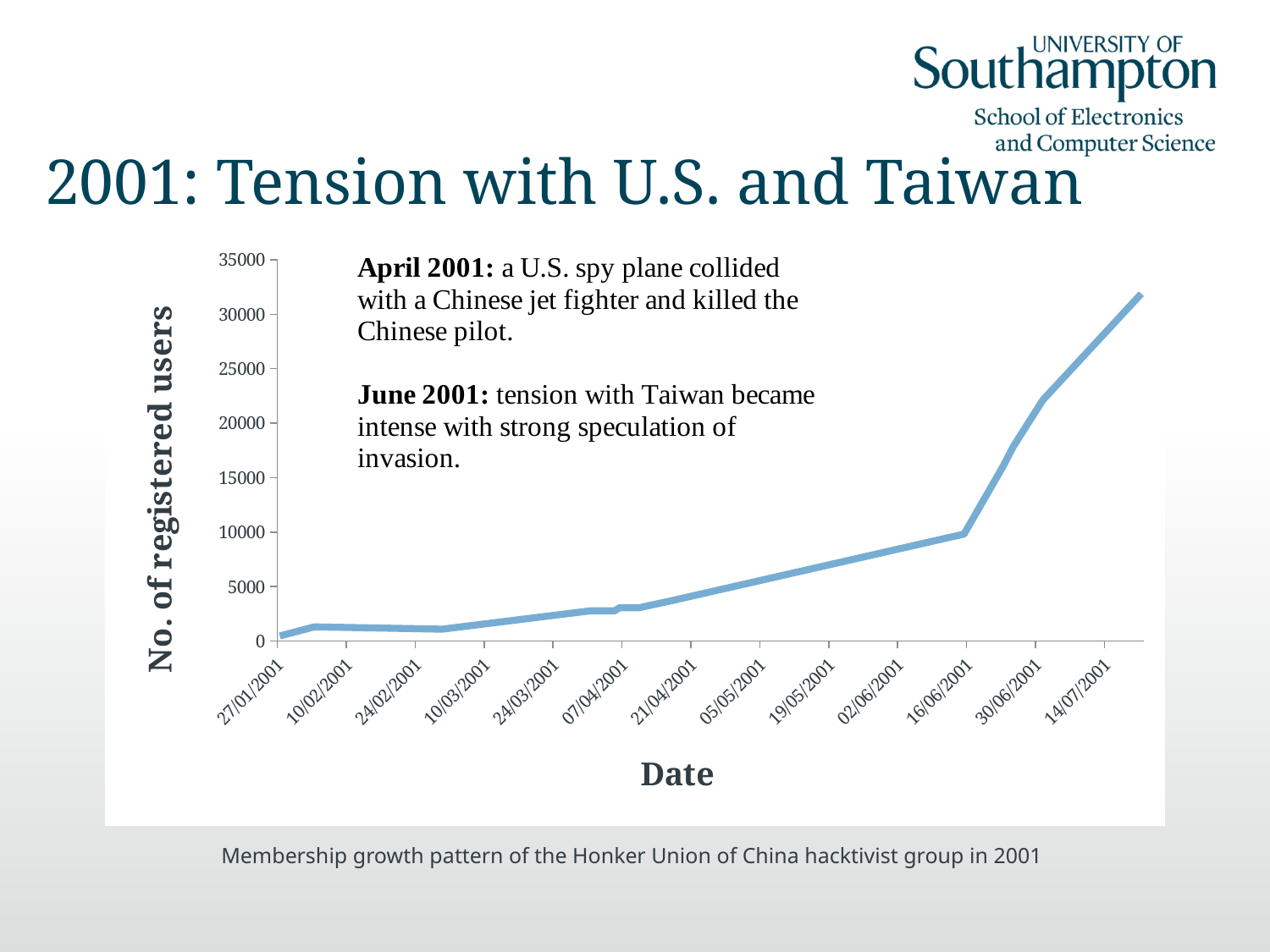
How many date labels are shown on the x axis? 13 Is the value for 30/06/2001 greater or less than 20000? greater Is the value for 02/06/2001 greater or less than 10000? less Do the values generally rise or fall from 27/01/2001 to the end of the series? rise What is the highest tick value shown on the y axis? 35000 Is the value for 16/06/2001 greater or less than 15000? less Which has the larger value, 16/06/2001 or 30/06/2001? 30/06/2001 What kind of chart is shown on the slide? line chart What is the title of the y axis? No. of registered users